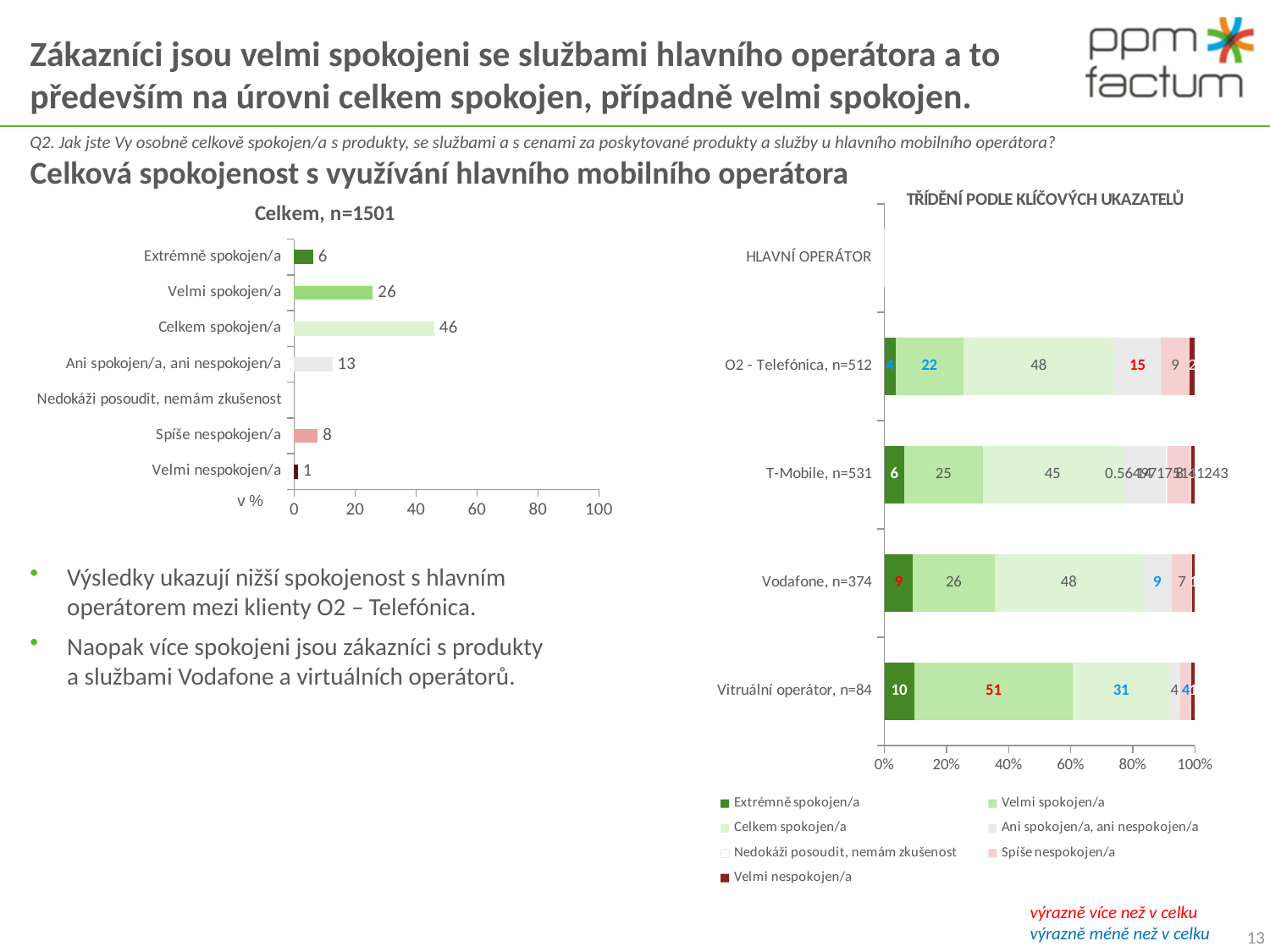
In the right chart 'TŘÍDĚNÍ PODLE KLÍČOVÝCH UKAZATELŮ', what is the 'Celkem spokojen/a' value for 'O2 - Telefónica, n=512'? 48 In the left chart 'Celkem, n=1501', what is the value for 'Spíše nespokojen/a'? 8 How many series does the legend of the right chart 'TŘÍDĚNÍ PODLE KLÍČOVÝCH UKAZATELŮ' list? 7 In the left chart 'Celkem, n=1501', which category has the highest value? Celkem spokojen/a How many operator categories are shown in the right chart 'TŘÍDĚNÍ PODLE KLÍČOVÝCH UKAZATELŮ'? 4 In the right chart 'TŘÍDĚNÍ PODLE KLÍČOVÝCH UKAZATELŮ', what is the 'Velmi spokojen/a' value for 'Vitruální operátor, n=84'? 51 In the left chart 'Celkem, n=1501', is the value for 'Celkem spokojen/a' greater or less than 40? greater In the left chart 'Celkem, n=1501', what is the value for 'Velmi spokojen/a'? 26 In the left chart 'Celkem, n=1501', what is the value for 'Celkem spokojen/a'? 46 What kind of chart is the left chart 'Celkem, n=1501'? bar chart In the left chart 'Celkem, n=1501', what is the difference between 'Celkem spokojen/a' and 'Velmi spokojen/a'? 20 In the left chart 'Celkem, n=1501', which is larger: 'Ani spokojen/a, ani nespokojen/a' or 'Spíše nespokojen/a'? Ani spokojen/a, ani nespokojen/a